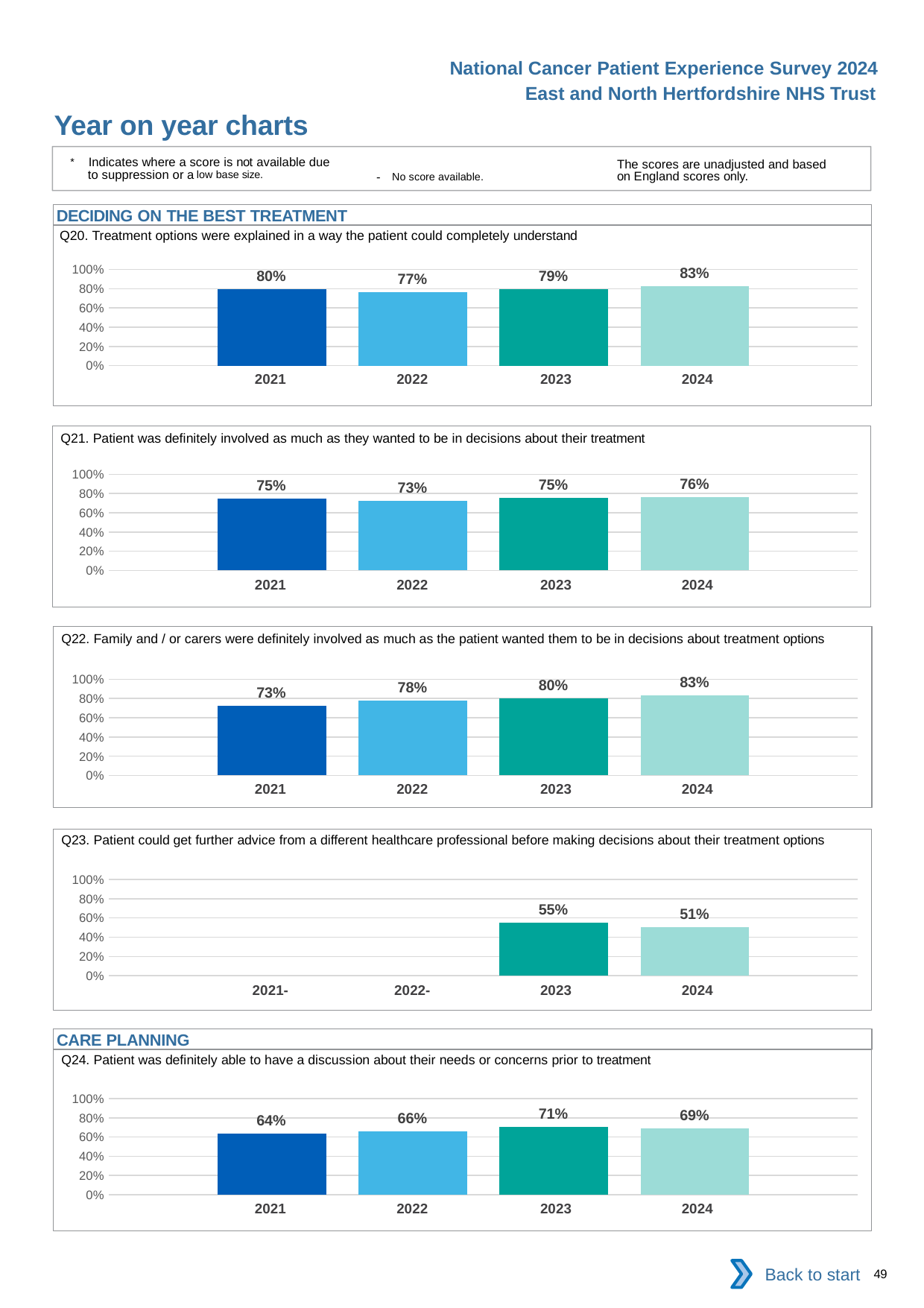
In the Q24 chart (Patient was definitely able to have a discussion about their needs or concerns prior to treatment), which is larger, the value for 2023 or the value for 2024? 2023 In the Q23 chart, is the value for 2024 greater or less than 60%? less In the Q23 chart, how many years have a bar plotted? 2 What kind of chart is the Q24 chart? bar chart In the Q20 chart, which year has the lowest value? 2022 In the Q20 chart (Treatment options were explained in a way the patient could completely understand), what is the value for 2024? 83% In the Q21 chart (Patient was definitely involved as much as they wanted to be in decisions about their treatment), what is the value for 2022? 73% In the Q22 chart, do the values rise or fall from 2021 to 2024? rise In the Q22 chart (Family and / or carers were definitely involved as much as the patient wanted them to be in decisions about treatment options), which year has the highest value? 2024 In the Q21 chart, what is the difference between the 2024 value and the 2022 value? 3% In the Q24 chart, what is the difference between the 2023 value and the 2021 value? 7% In the Q23 chart (Patient could get further advice from a different healthcare professional before making decisions about their treatment options), what is the value for 2023? 55%